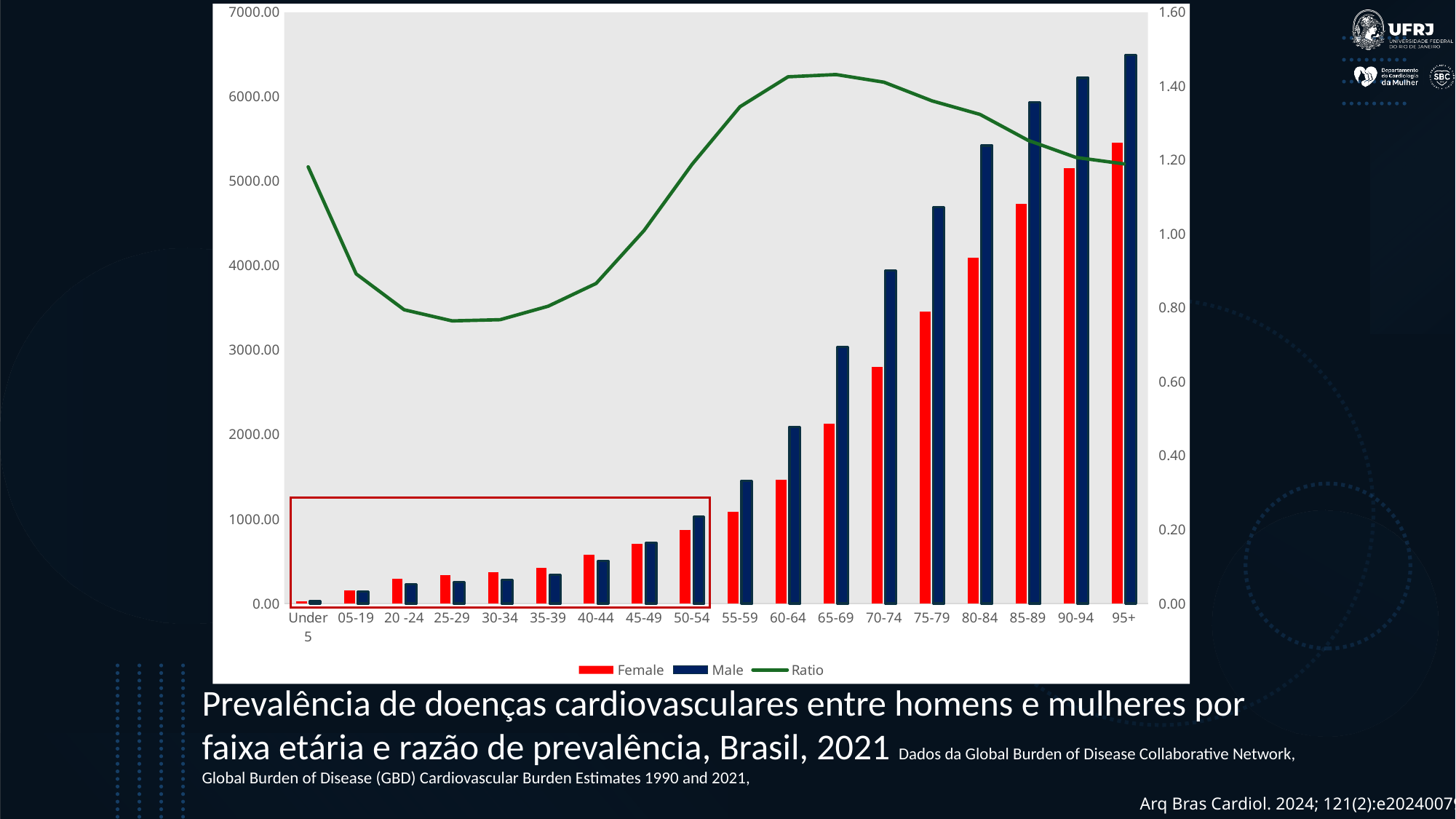
Do the Male values rise or fall as the age groups move from Under 5 to 95+? rise Is the Male value for 95+ greater or less than 6000.00? greater Is the Ratio value for Under 5 greater or less than 1.00? greater Is the Ratio value for 25-29 greater or less than 0.80? less Which age group has the highest Male value? 95+ How many series does the chart's legend list? 3 For the 35-39 age group, which is larger, the Female value or the Male value? Female How many age-group categories are shown on the x axis of the chart? 18 What kind of chart is shown on the slide? Bar chart with a line series Which age group has the lowest Female value? Under 5 For the 95+ age group, which is larger, the Female value or the Male value? Male